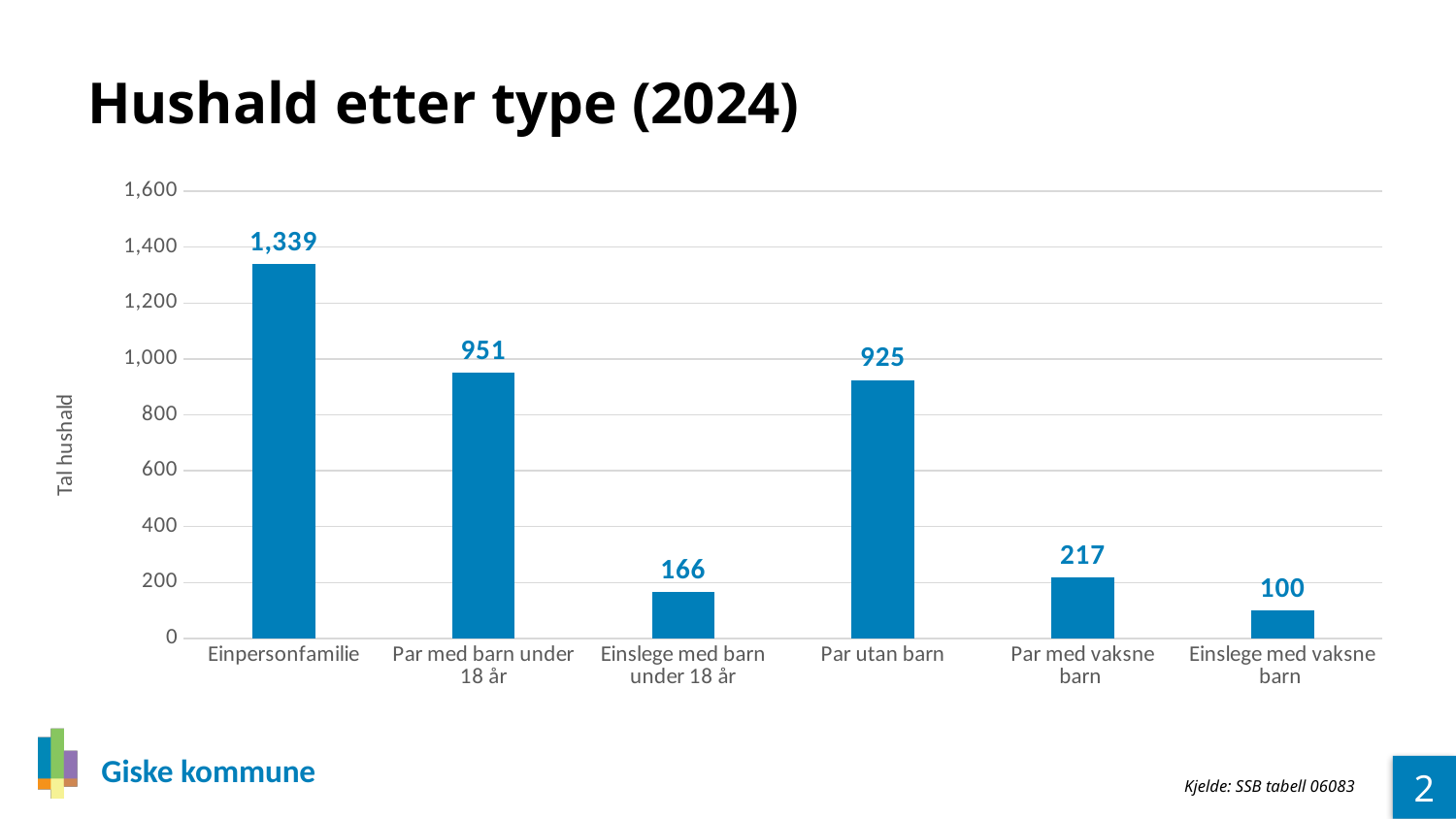
Which household type has the lowest value? Einslege med vaksne barn Which household type has the highest value? Einpersonfamilie What kind of chart is shown on the slide? bar chart What is the value for Einslege med vaksne barn? 100 What is the label on the vertical axis? Tal hushald How many household types are shown on the chart? 6 What is the value for Einpersonfamilie? 1,339 Which is larger: Par med vaksne barn or Einslege med barn under 18 år? Par med vaksne barn What is the title of the chart? Hushald etter type (2024) Is the value for Par med barn under 18 år greater or less than 1,000? less What is the value for Par utan barn? 925 What is the difference between Par med barn under 18 år and Par utan barn? 26